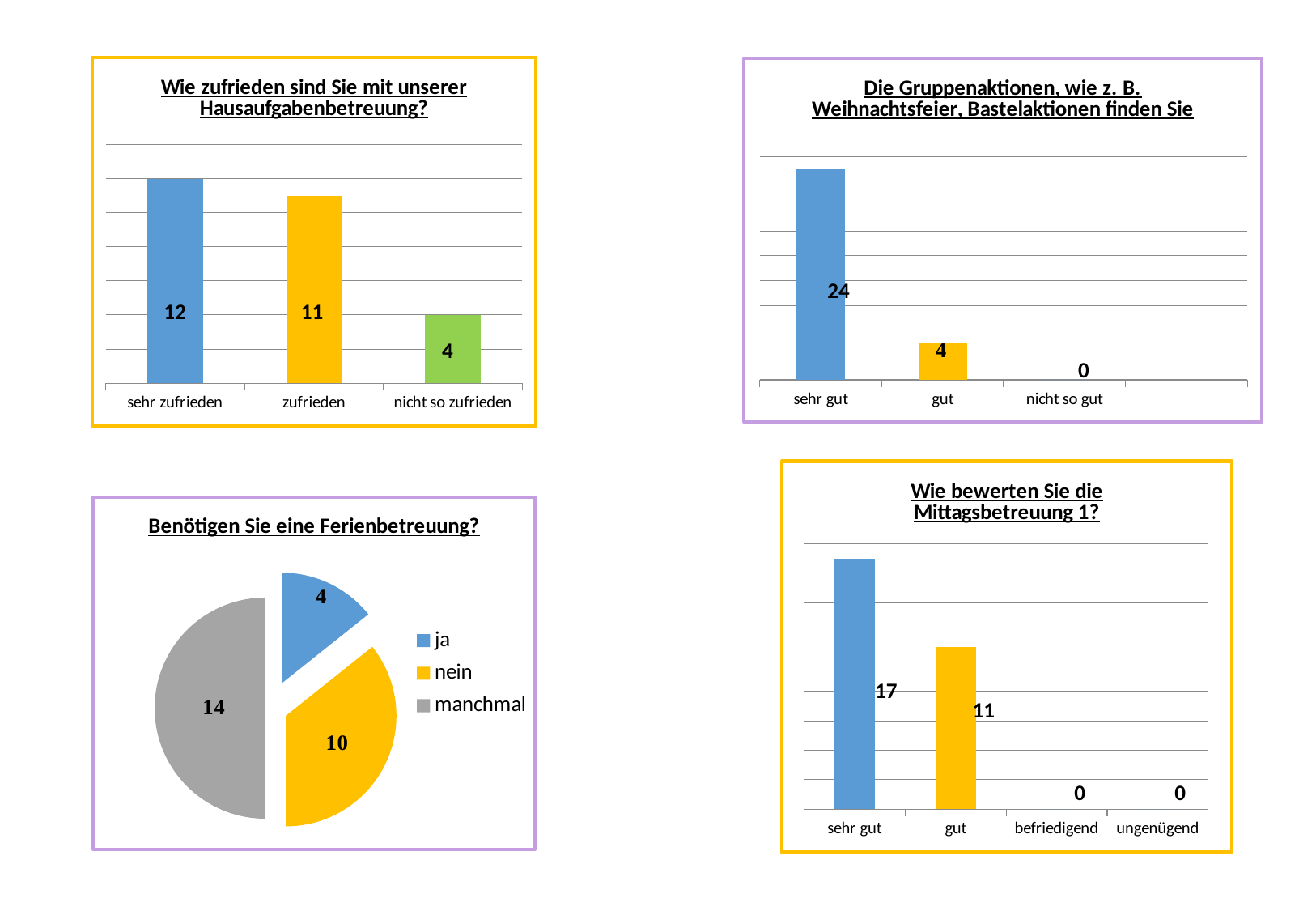
In the chart 'Die Gruppenaktionen, wie z. B. Weihnachtsfeier, Bastelaktionen finden Sie', what is the value for 'sehr gut'? 24 In the chart 'Die Gruppenaktionen, wie z. B. Weihnachtsfeier, Bastelaktionen finden Sie', do the values rise or fall from left to right? fall What kind of chart is 'Benötigen Sie eine Ferienbetreuung?'? pie chart In the chart 'Wie bewerten Sie die Mittagsbetreuung 1?', which is larger, 'sehr gut' or 'gut'? sehr gut How many entries does the legend of the pie chart 'Benötigen Sie eine Ferienbetreuung?' list? 3 In the pie chart 'Benötigen Sie eine Ferienbetreuung?', what is the value for 'nein'? 10 In the chart 'Wie bewerten Sie die Mittagsbetreuung 1?', what is the value for 'befriedigend'? 0 In the chart 'Wie zufrieden sind Sie mit unserer Hausaufgabenbetreuung?', what is the difference between 'sehr zufrieden' and 'nicht so zufrieden'? 8 In the chart 'Wie zufrieden sind Sie mit unserer Hausaufgabenbetreuung?', what is the value for 'zufrieden'? 11 In the chart 'Wie zufrieden sind Sie mit unserer Hausaufgabenbetreuung?', which category has the lowest value? nicht so zufrieden In the pie chart 'Benötigen Sie eine Ferienbetreuung?', what share of the total does 'manchmal' represent? 50% In the chart 'Die Gruppenaktionen, wie z. B. Weihnachtsfeier, Bastelaktionen finden Sie', how many categories are shown on the x axis? 3